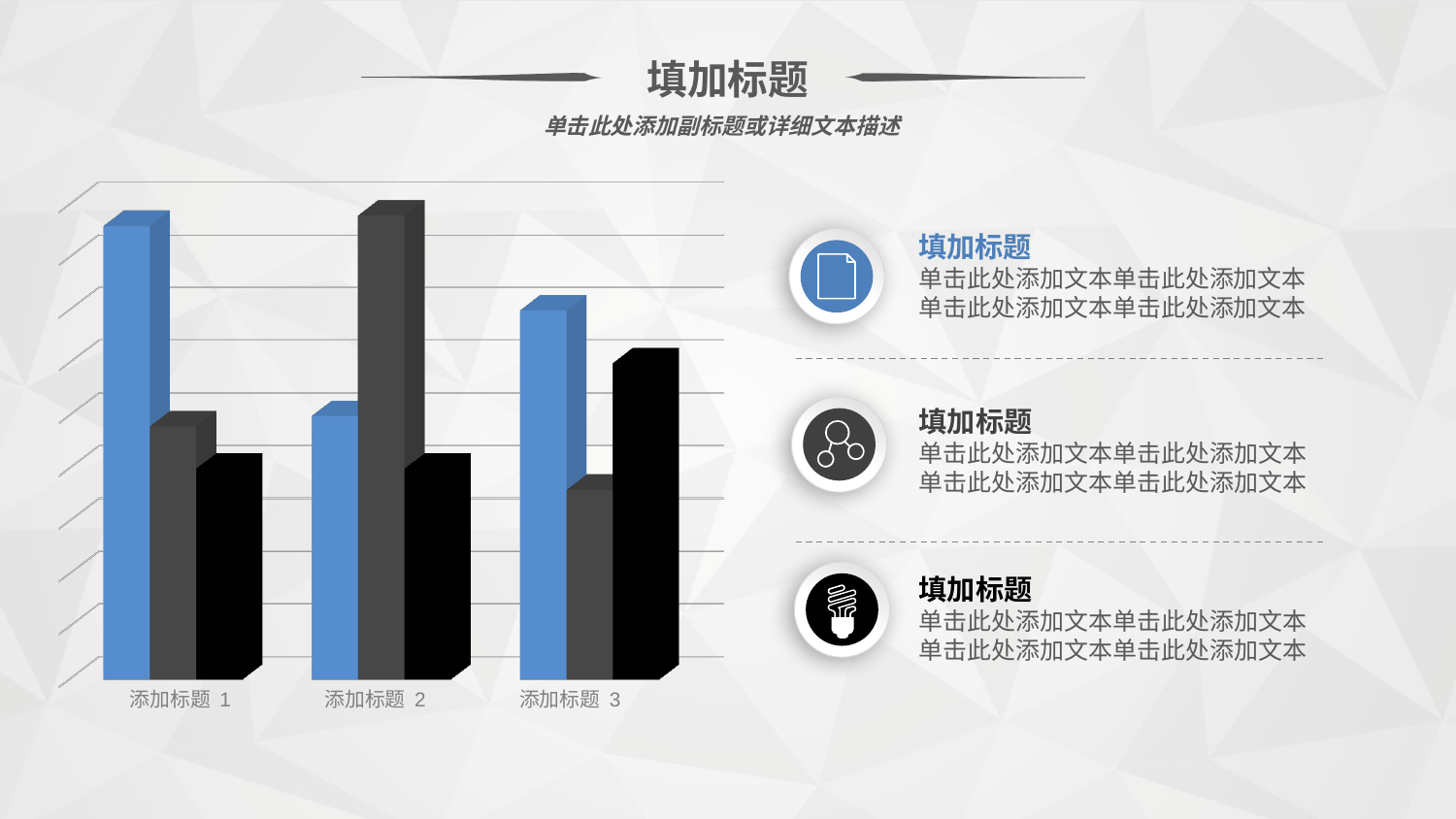
In the category 添加标题 2, which coloured bar is the shortest? black How many bars are plotted for each category in the bar chart? 3 Is the black bar taller in 添加标题 3 or in 添加标题 1? 添加标题 3 What kind of chart is shown on the left of the slide? bar chart Is the dark gray bar taller in 添加标题 1 or in 添加标题 3? 添加标题 1 In the category 添加标题 2, which coloured bar is the tallest? dark gray How many bars are plotted in total in the bar chart? 9 How many categories are shown on the x axis of the bar chart? 3 In the category 添加标题 3, which coloured bar is the shortest? dark gray In the category 添加标题 1, which coloured bar is the tallest? blue Does the bar chart display a legend identifying the bar colours? No Is the blue bar taller in 添加标题 1 or in 添加标题 2? 添加标题 1